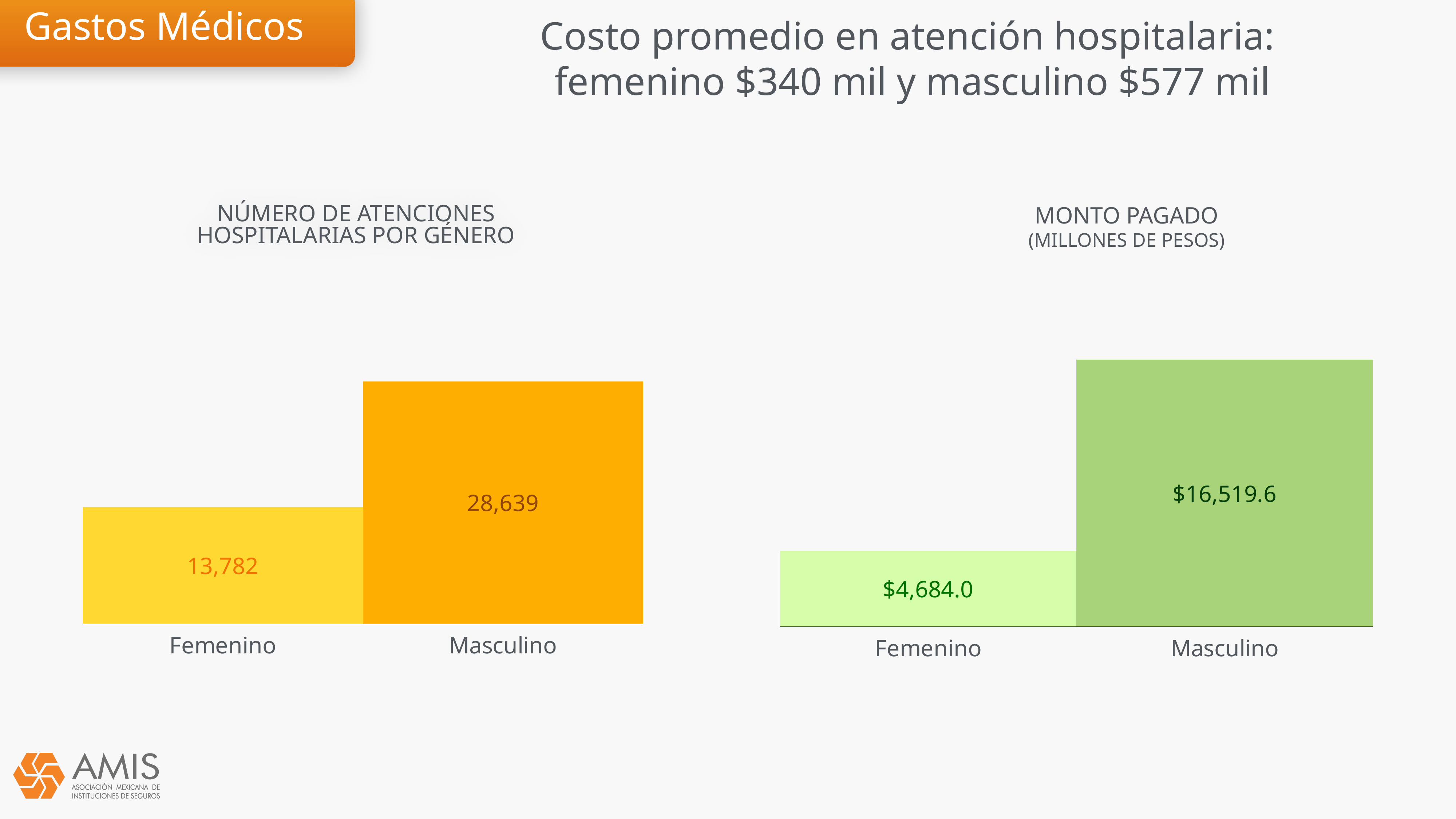
In the chart titled 'NÚMERO DE ATENCIONES HOSPITALARIAS POR GÉNERO', what is the difference between the Masculino and Femenino values? 14,857 In the chart titled 'NÚMERO DE ATENCIONES HOSPITALARIAS POR GÉNERO', what is the value for Femenino? 13,782 In the chart titled 'MONTO PAGADO (MILLONES DE PESOS)', what is the value for Masculino? $16,519.6 In the chart titled 'MONTO PAGADO (MILLONES DE PESOS)', which category has the lowest value? Femenino What kind of chart is the chart titled 'MONTO PAGADO (MILLONES DE PESOS)'? Bar chart How many categories are shown in the chart titled 'NÚMERO DE ATENCIONES HOSPITALARIAS POR GÉNERO'? 2 In the chart titled 'MONTO PAGADO (MILLONES DE PESOS)', which is larger, the value for Femenino or the value for Masculino? Masculino In the chart titled 'MONTO PAGADO (MILLONES DE PESOS)', what is the difference between the Masculino and Femenino values? $11,835.6 In the chart titled 'NÚMERO DE ATENCIONES HOSPITALARIAS POR GÉNERO', what is the value for Masculino? 28,639 What is the title of the chart on the right side of the slide? MONTO PAGADO (MILLONES DE PESOS) In the chart titled 'MONTO PAGADO (MILLONES DE PESOS)', what is the value for Femenino? $4,684.0 In the chart titled 'NÚMERO DE ATENCIONES HOSPITALARIAS POR GÉNERO', which category has the highest value? Masculino